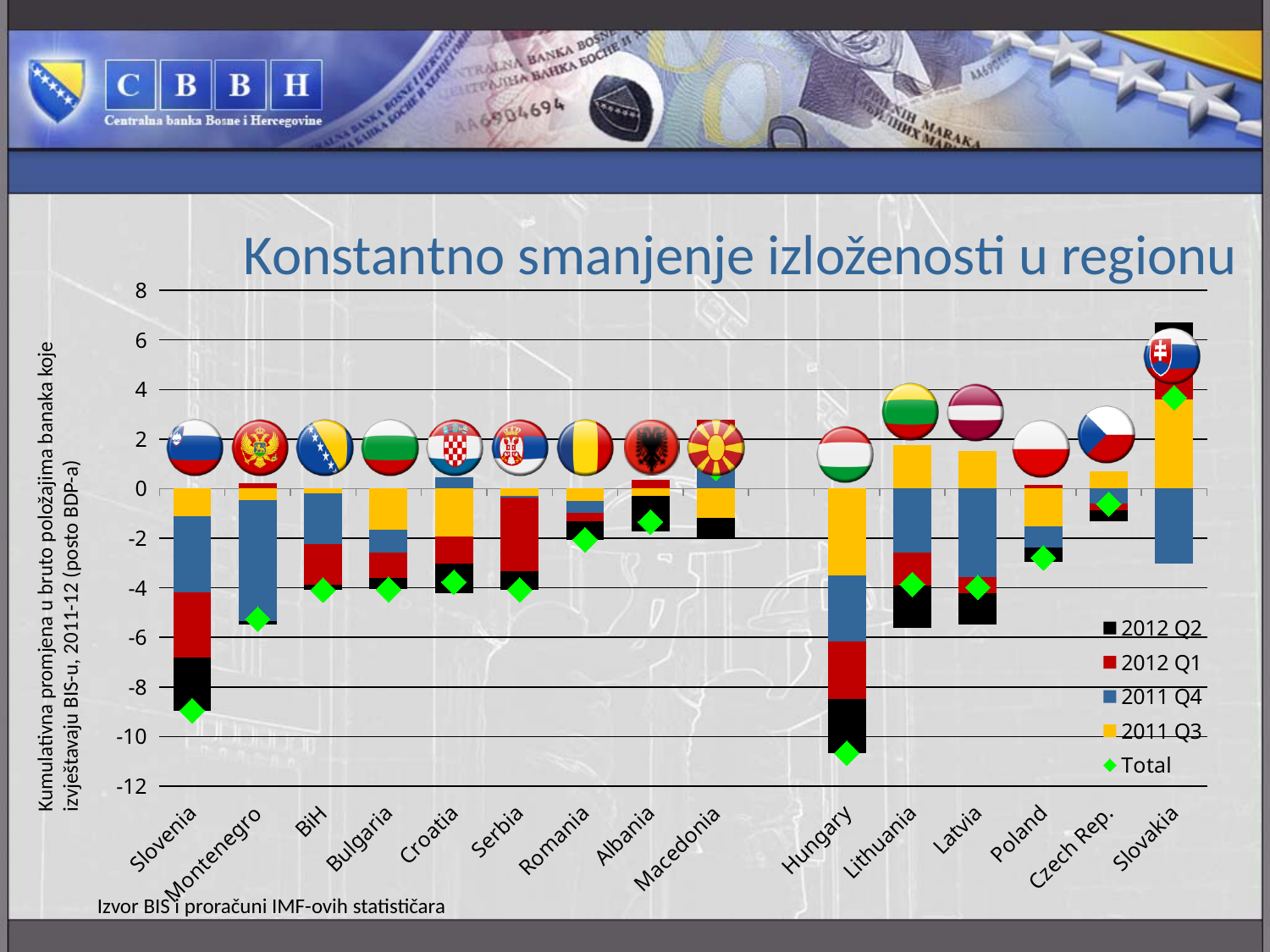
Is the Total value for Slovenia greater or less than -8? less Which has the lower Total value, Slovenia or Hungary? Hungary Is the Total value for Slovakia greater or less than 2? greater Is the Total value for Hungary greater or less than -10? less What is the title of the chart? Konstantno smanjenje izloženosti u regionu How many entries does the chart's legend list? 5 What kind of chart is shown on the slide? bar chart Which country has the highest Total value in the chart? Slovakia Which colour represents the 2011 Q3 series in the chart? yellow Which country has the lowest Total value in the chart? Hungary How many countries are shown on the x axis of the chart? 15